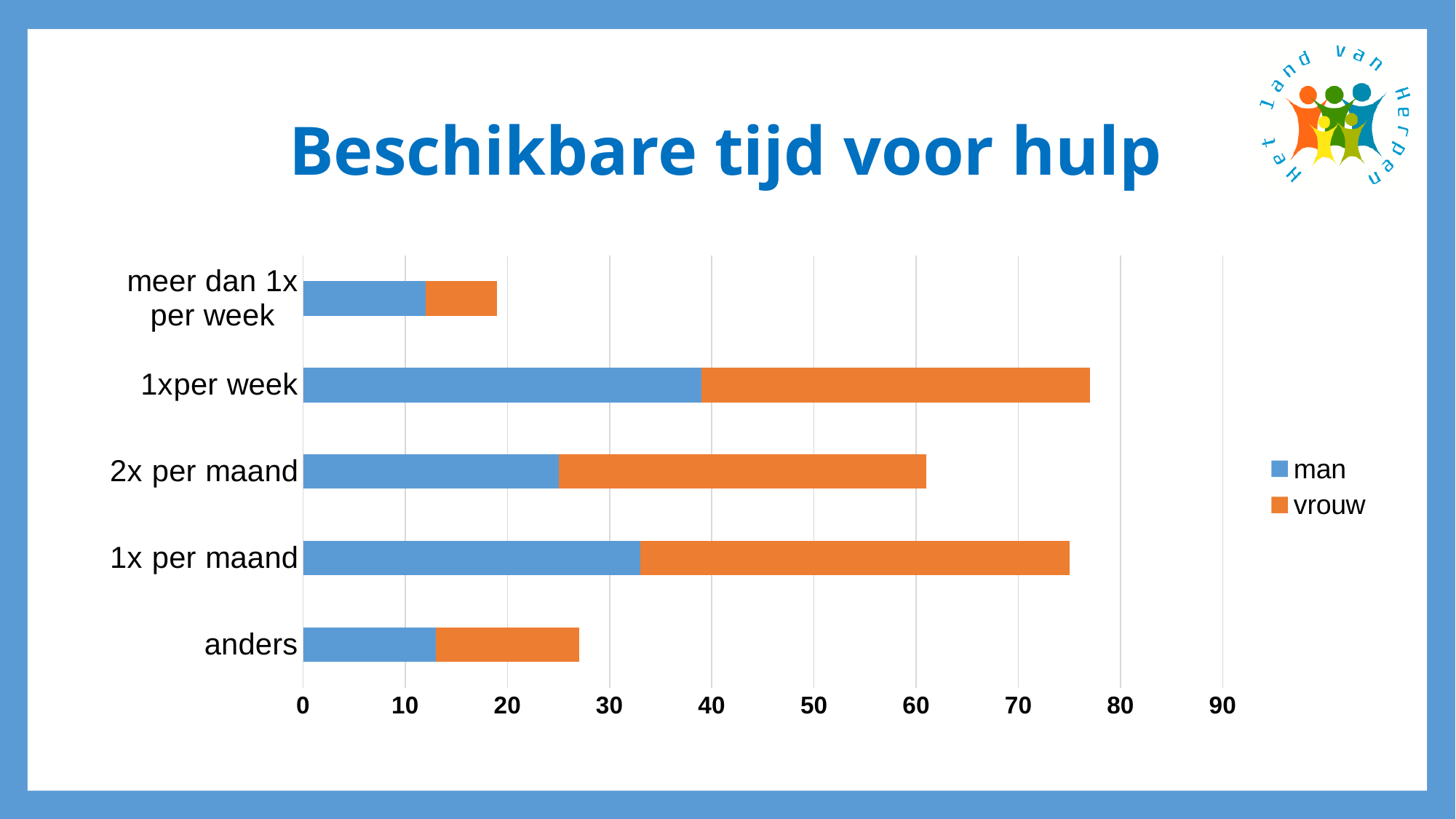
Which category has the lowest total bar length? meer dan 1x per week Which series is shown in orange? vrouw What is the title of the chart? Beschikbare tijd voor hulp Which category has the largest 'man' segment? 1xper week Which has the larger total bar: '2x per maand' or 'anders'? 2x per maand How many series does the legend list? 2 How many categories are shown on the chart? 5 Is the total value for '1xper week' greater or less than 70? greater Is the 'man' value for '1xper week' greater or less than 30? greater Is the total value for 'anders' greater or less than 30? less What kind of chart is shown on the slide? stacked bar chart Which category has the smallest 'vrouw' segment? meer dan 1x per week